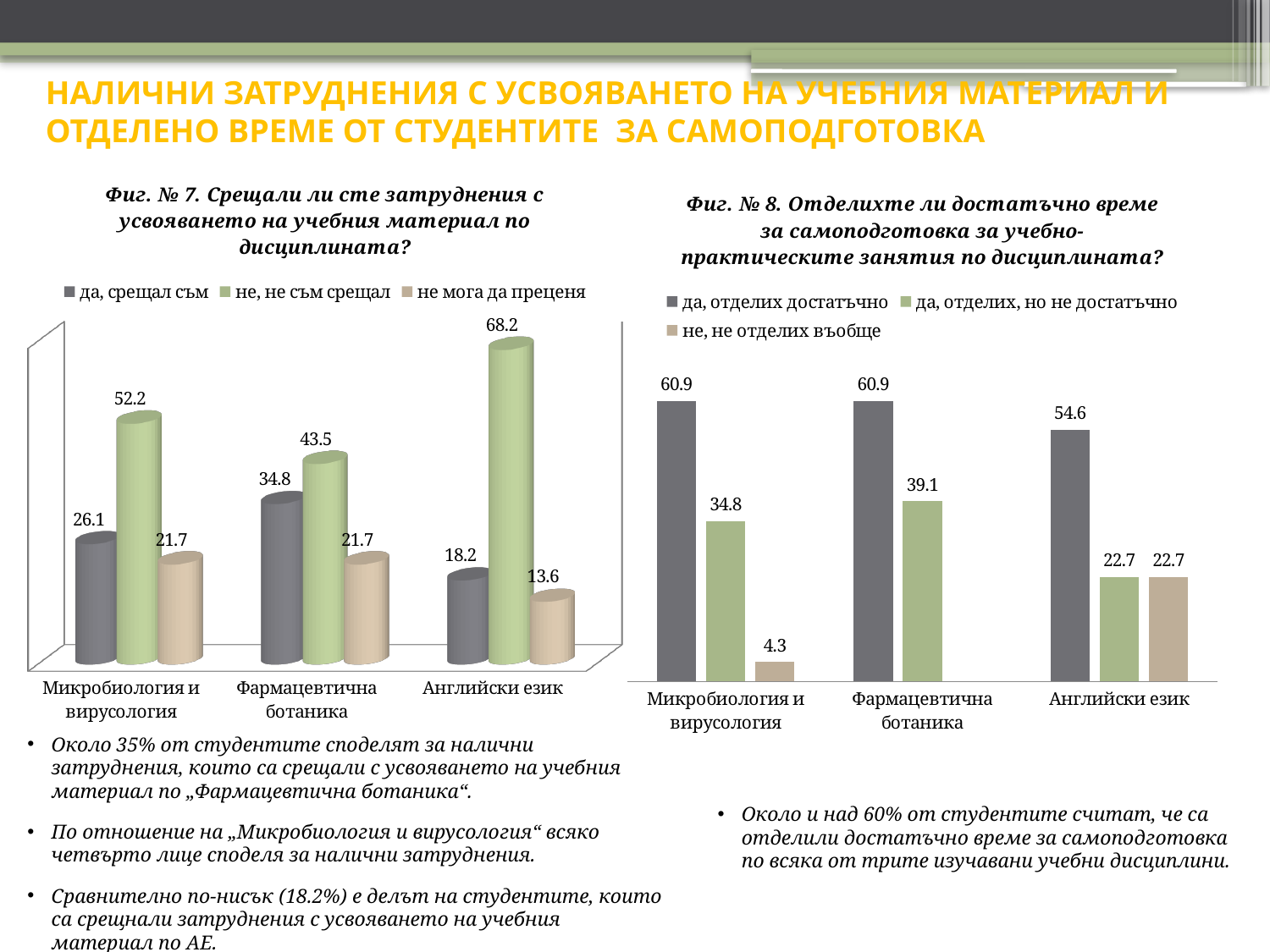
In the right chart (Фиг. № 8), what is the value of "не, не отделих въобще" for Микробиология и вирусология? 4.3 What type of chart is the left chart (Фиг. № 7)? Bar chart In the right chart (Фиг. № 8), what is the value of "да, отделих, но не достатъчно" for Фармацевтична ботаника? 39.1 In the left chart (Фиг. № 7), what is the value of "да, срещал съм" for Фармацевтична ботаника? 34.8 In the left chart (Фиг. № 7), what is the value of "не, не съм срещал" for Английски език? 68.2 In the left chart (Фиг. № 7), what is the difference between "не, не съм срещал" and "да, срещал съм" for Микробиология и вирусология? 26.1 In the left chart (Фиг. № 7), what is the value of "не мога да преценя" for Микробиология и вирусология? 21.7 In the left chart (Фиг. № 7), which category has the lowest value for "да, срещал съм"? Английски език In the right chart (Фиг. № 8), is the value of "да, отделих достатъчно" larger for Микробиология и вирусология or for Английски език? Микробиология и вирусология In the right chart (Фиг. № 8), which category has the lowest value for "да, отделих достатъчно"? Английски език In the left chart (Фиг. № 7), which category has the highest value for "не, не съм срещал"? Английски език How many series does the legend of the right chart (Фиг. № 8) list? 3